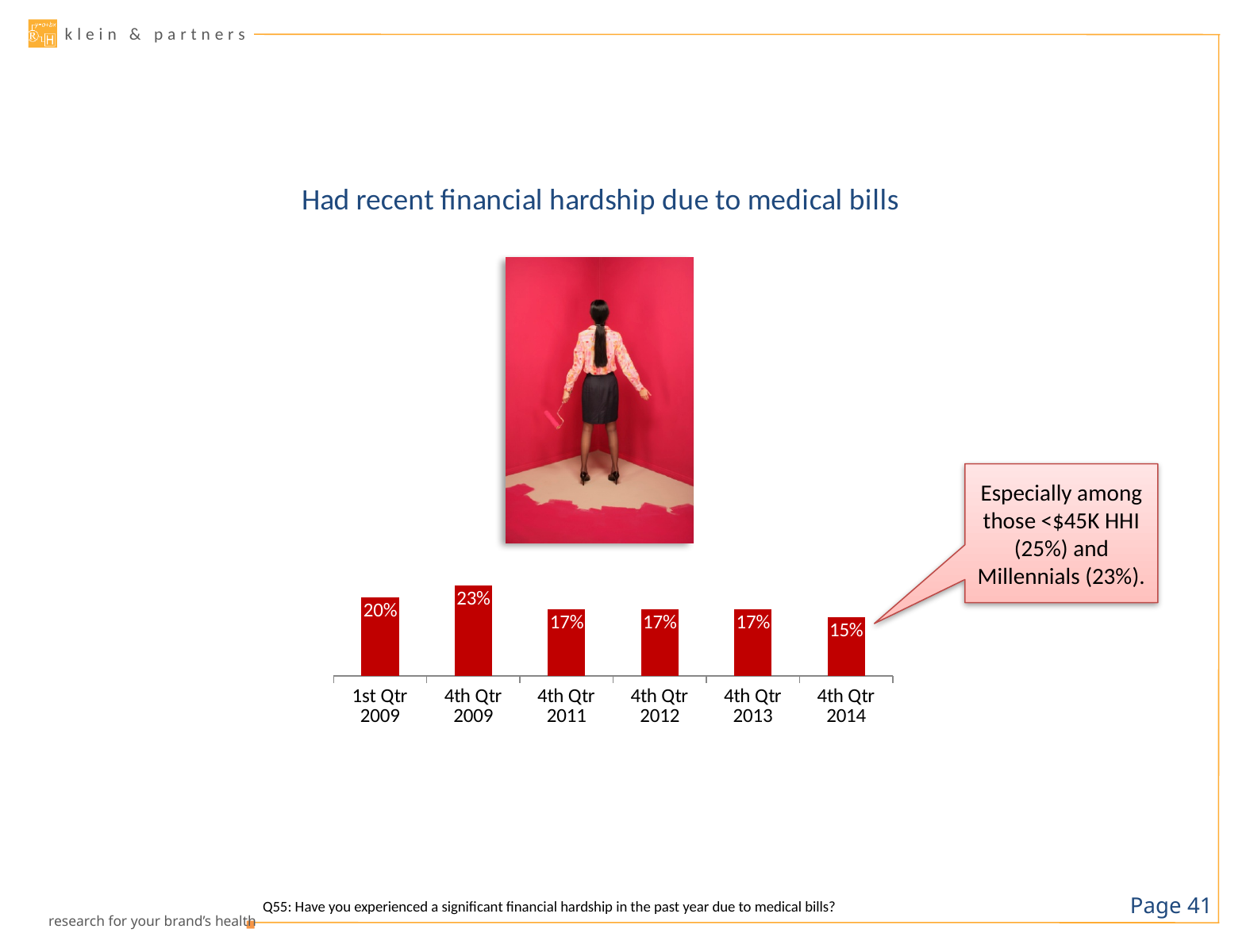
What is the title of the chart? Had recent financial hardship due to medical bills What is the difference between the values for 4th Qtr 2009 and 4th Qtr 2014? 8% What kind of chart is this? bar chart How many categories are shown on the x axis? 6 What is the value for 1st Qtr 2009? 20% What is the value for 4th Qtr 2014? 15% Which category has the lowest value? 4th Qtr 2014 Which is larger, the value for 1st Qtr 2009 or the value for 4th Qtr 2013? 1st Qtr 2009 What is the value for 4th Qtr 2012? 17% Do the values generally rise or fall from 4th Qtr 2009 to 4th Qtr 2014? fall Which category has the highest value? 4th Qtr 2009 What is the difference between the values for 1st Qtr 2009 and 4th Qtr 2011? 3%